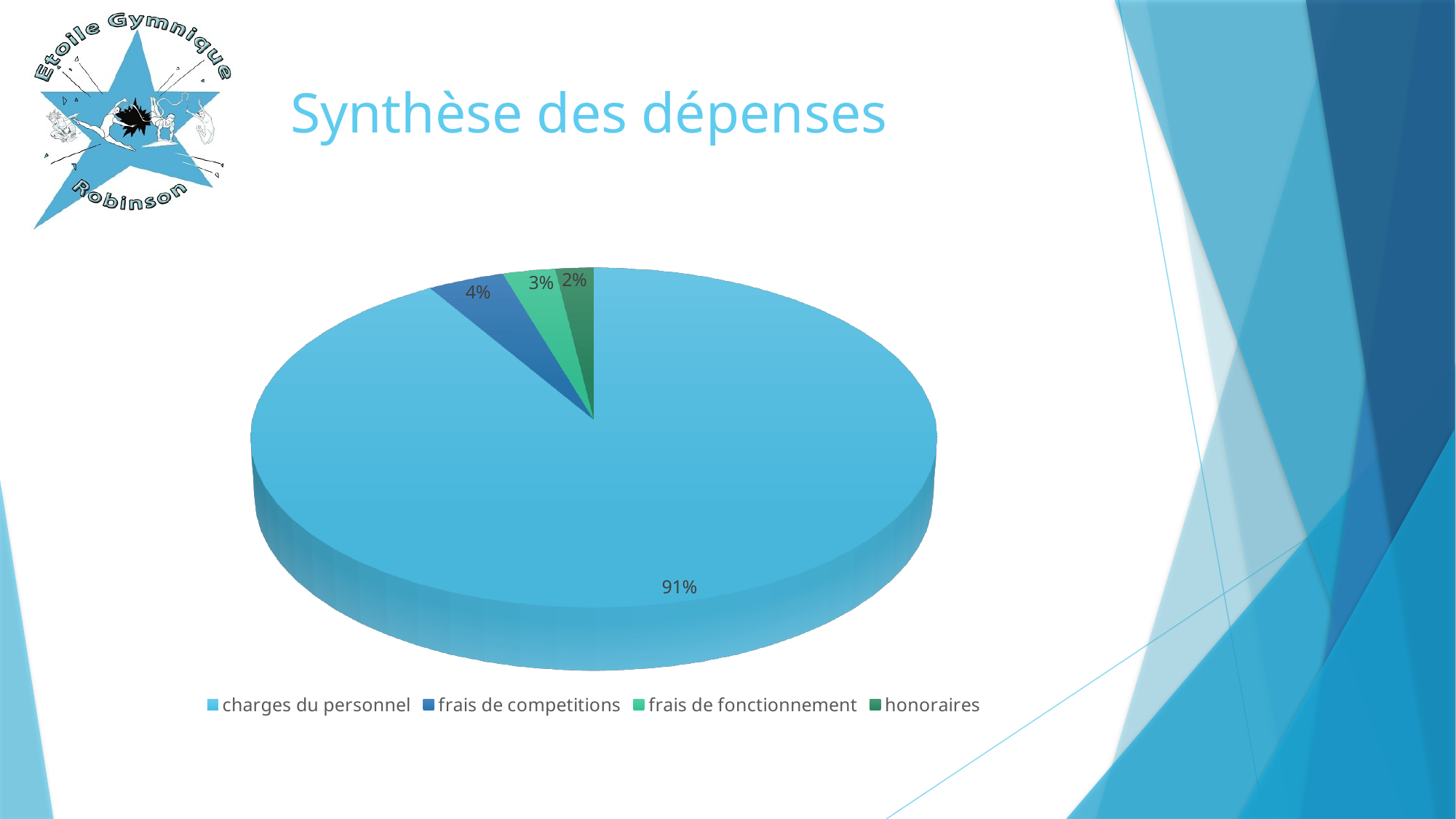
What is the title of the slide containing the chart? Synthèse des dépenses What share of the pie does 'frais de fonctionnement' represent? 3% Which category has the smallest slice of the pie? honoraires What share of the pie does 'charges du personnel' represent? 91% Which is larger, the slice for 'frais de competitions' or the slice for 'honoraires'? frais de competitions What is the difference in percentage points between 'charges du personnel' and 'frais de competitions'? 87 Which legend entry is shown in dark green? honoraires Which category has the largest slice of the pie? charges du personnel What share of the pie does 'frais de competitions' represent? 4% How many categories does the pie chart show? 4 What kind of chart is shown on the slide? pie chart